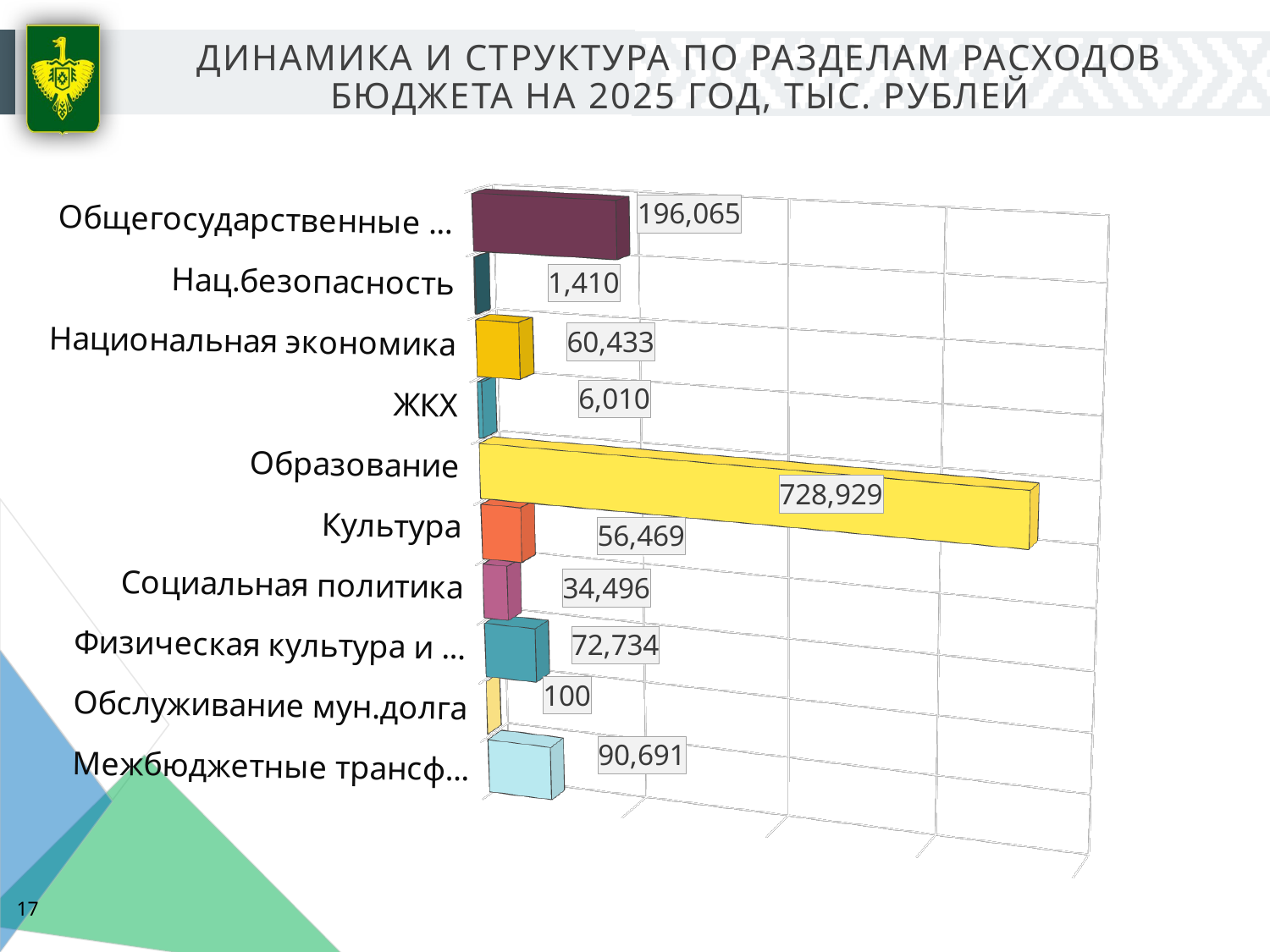
What is the difference between the values for ЖКХ and Нац.безопасность? 4,600 Which is larger, the value for Физическая культура or the value for Национальная экономика? Физическая культура What is the difference between the values for Образование and Общегосударственные? 532,864 Which category has the lowest value? Обслуживание мун.долга What kind of chart is shown on the slide? Bar chart Which is larger, the value for Культура or the value for Межбюджетные трансф...? Межбюджетные трансф... Which category has the highest value? Образование What is the value for Образование? 728,929 What is the value for Социальная политика? 34,496 What is the value for Обслуживание мун.долга? 100 How many categories are shown in the chart? 10 What is the value for Национальная экономика? 60,433